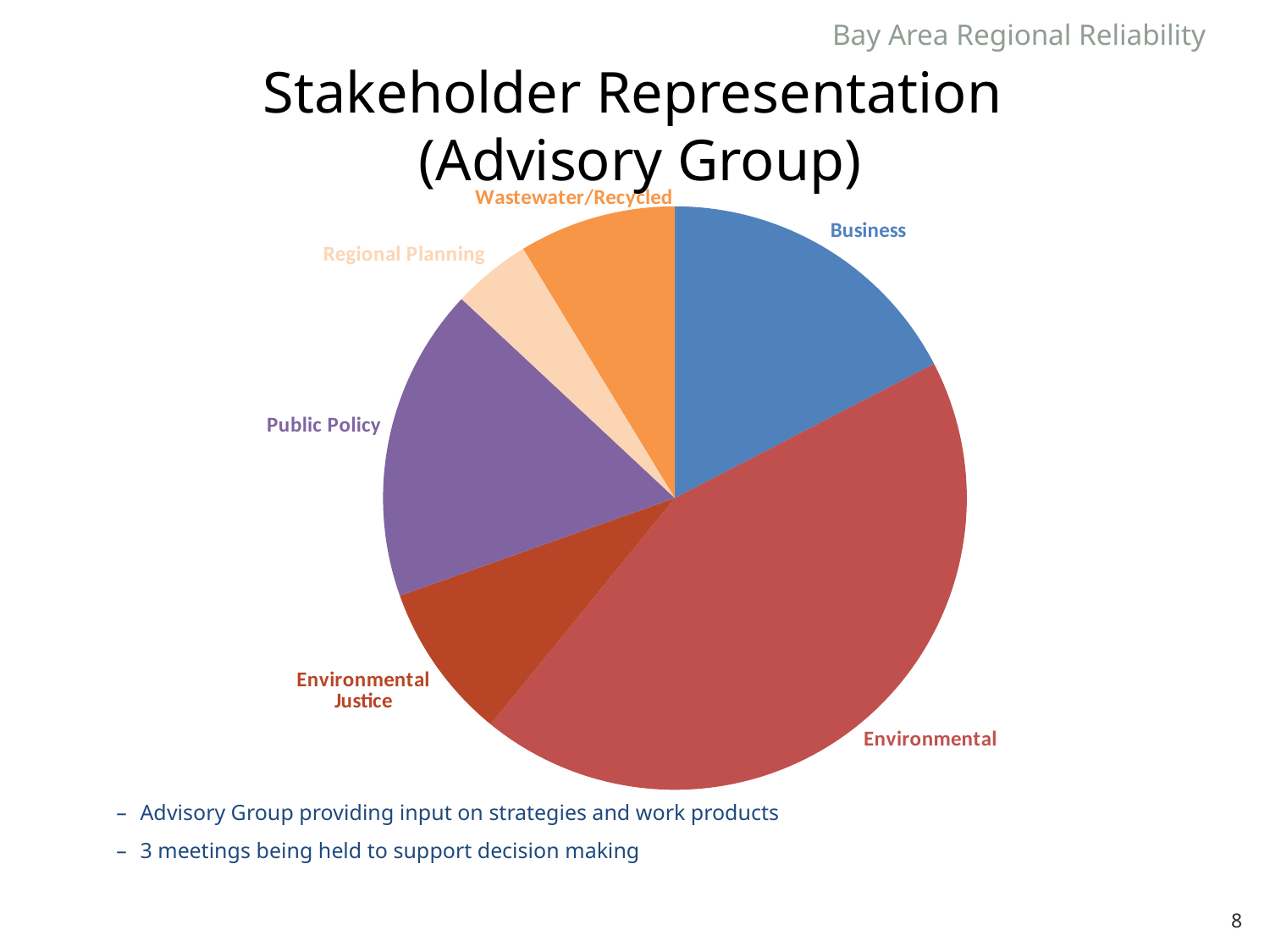
Does the Environmental slice make up more or less than half of the pie? less Which slice is larger, Public Policy or Regional Planning? Public Policy Which slice is larger, Environmental or Business? Environmental What is the title of the chart on the slide? Stakeholder Representation (Advisory Group) What kind of chart is shown on the slide? pie chart Which category has the smallest slice of the pie chart? Regional Planning Which category has the largest slice of the pie chart? Environmental What colour is the Business slice of the pie chart? blue How many slices does the pie chart have? 6